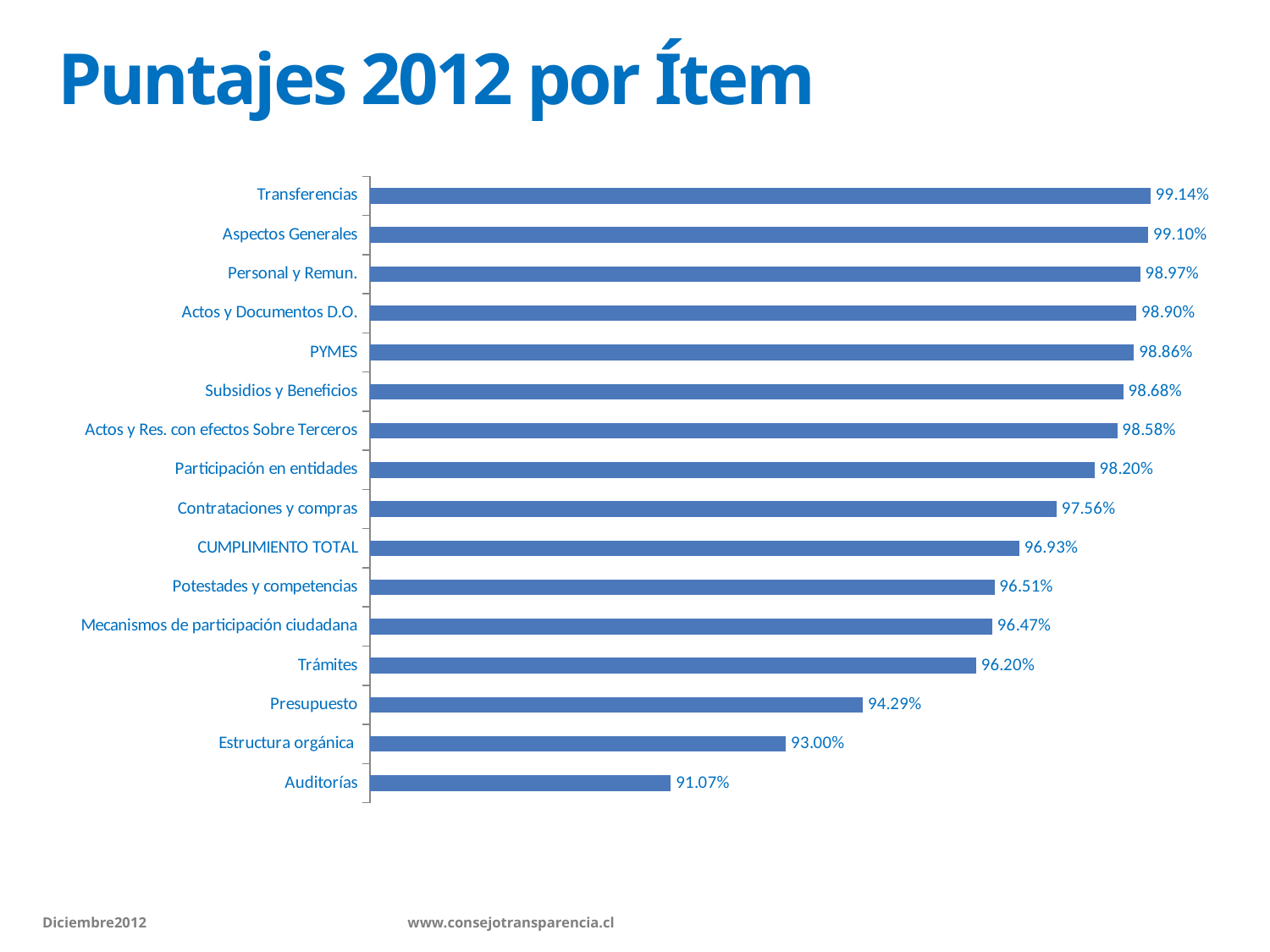
What kind of chart is shown on the slide? Bar chart What is the title of the slide? Puntajes 2012 por Ítem Which category has the highest value? Transferencias What is the value for Presupuesto? 94.29% Which is larger, the value for Trámites or the value for Presupuesto? Trámites What is the difference between the values for Transferencias and Auditorías? 8.07% What is the value for CUMPLIMIENTO TOTAL? 96.93% What is the value for Estructura orgánica? 93.00% What is the difference between the values for Presupuesto and Estructura orgánica? 1.29% How many categories are shown in the chart? 16 What is the value for Transferencias? 99.14% Which category has the lowest value? Auditorías